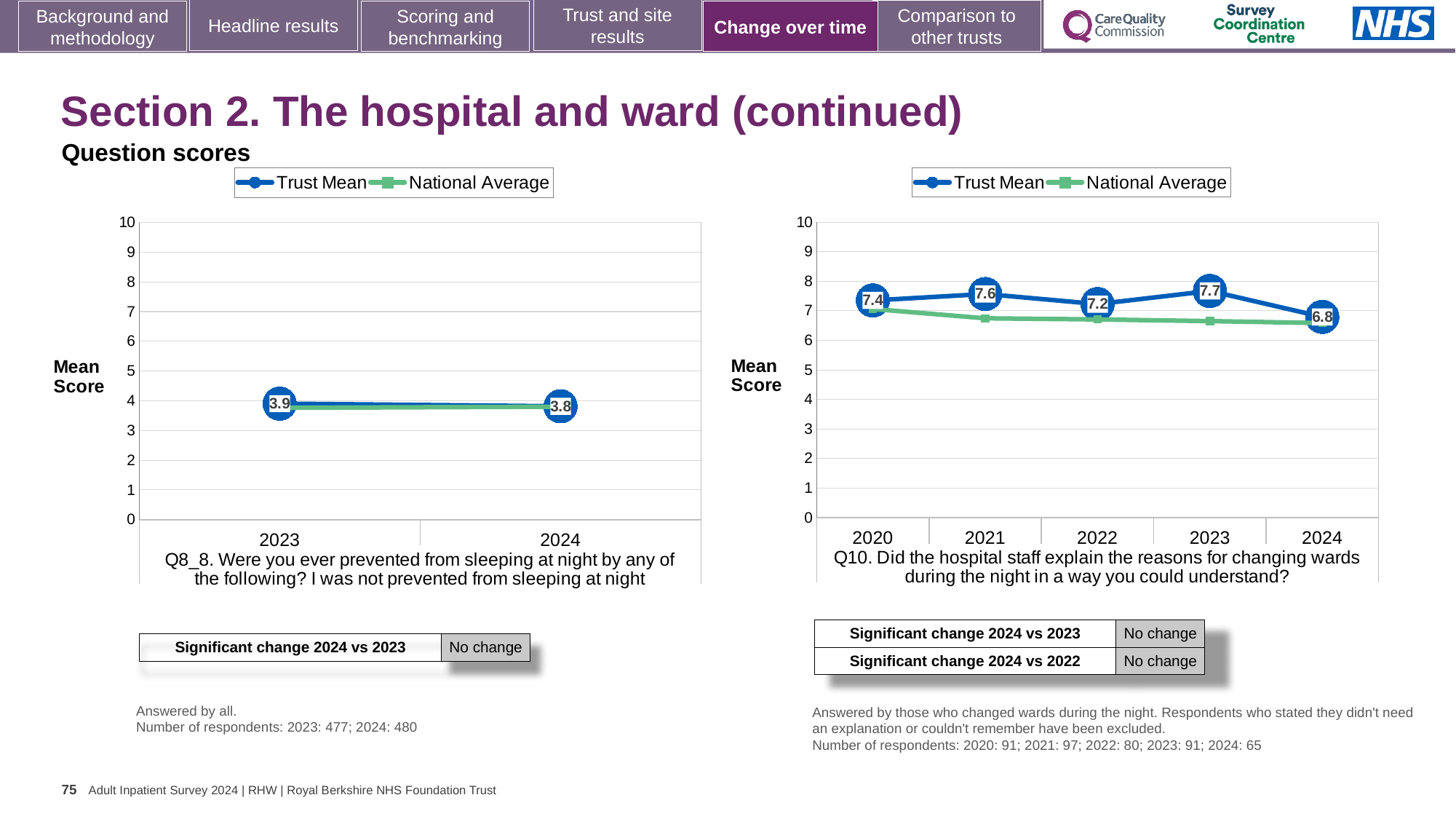
In the Q10 chart on the right, which year has the highest Trust Mean score? 2023 In the Q8_8 chart on the left, what is the Trust Mean score for 2023? 3.9 How many series does the legend of the Q10 chart on the right list? 2 In the Q8_8 chart on the left, how many years are shown on the x axis? 2 What kind of chart is the Q8_8 chart on the left? Line chart In the Q10 chart on the right, what is the difference between the Trust Mean scores for 2023 and 2024? 0.9 In the Q10 chart on the right, is the Trust Mean score for 2022 larger than the Trust Mean score for 2020? No In the Q10 chart on the right, what is the Trust Mean score for 2024? 6.8 In the Q8_8 chart on the left, what is the Trust Mean score for 2024? 3.8 In the Q10 chart on the right, which year has the lowest Trust Mean score? 2024 In the Q10 chart on the right, is the National Average value for 2024 greater or less than 7? less In the Q10 chart on the right, what is the Trust Mean score for 2021? 7.6